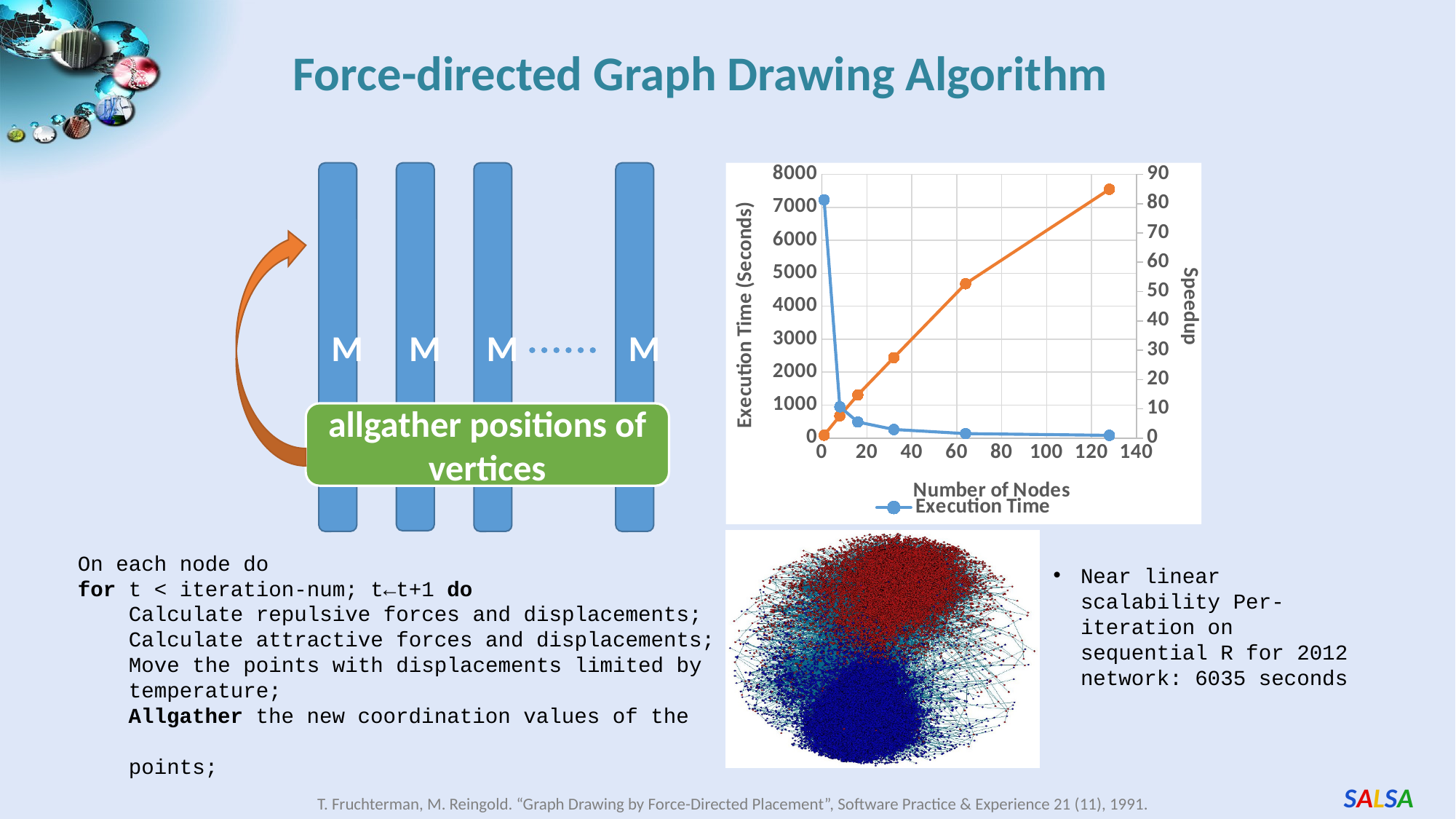
Is the Speedup at 64 nodes greater or less than 40? greater How many lines are plotted on the chart? 2 Is the Execution Time at 1 node greater or less than 6000 seconds? greater What kind of chart is shown on the slide? line chart What is the label of the right-hand vertical axis of the chart? Speedup Does the Speedup line (orange) rise or fall as the number of nodes increases? rise How many data points are plotted on the Execution Time line? 6 Does the Execution Time line rise or fall as the number of nodes increases? fall Is the Speedup at 128 nodes greater or less than 80? greater What is the label of the x axis of the chart? Number of Nodes